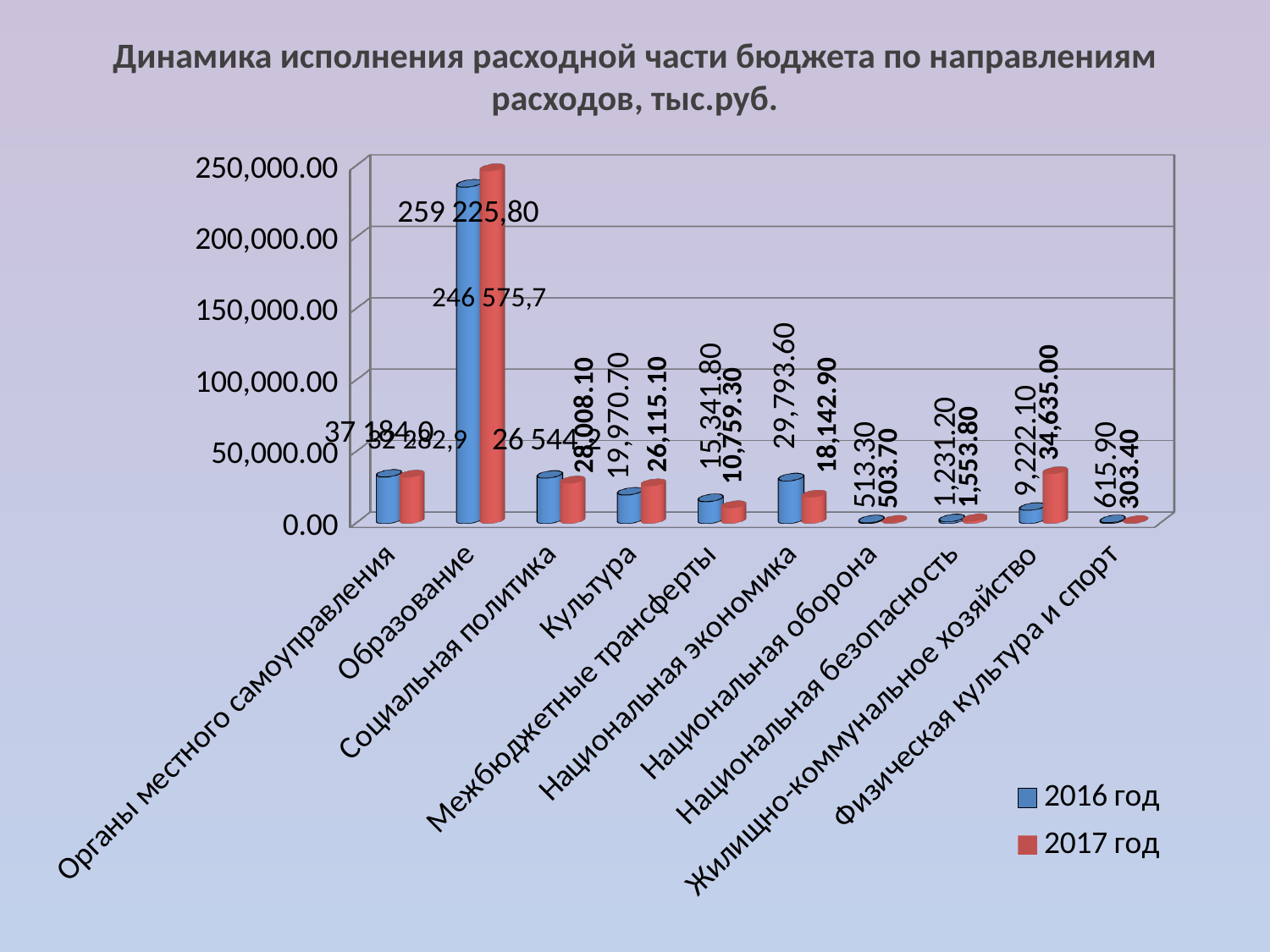
What is the difference between the 2017 год and 2016 год values for Культура? 6,144.40 What kind of chart is shown on the slide? Bar chart What is the value for Культура in 2017 год? 26,115.10 How many expenditure categories are shown on the x axis? 10 Which category has the highest values in the chart? Образование What is the value for Культура in 2016 год? 19,970.70 What are the two entries listed in the legend? 2016 год and 2017 год For Жилищно-коммунальное хозяйство, which year has the larger value, 2016 год or 2017 год? 2017 год What is the value for Жилищно-коммунальное хозяйство in 2017 год? 34,635.00 How many series does the legend list? 2 What is the value for Межбюджетные трансферты in 2017 год? 10,759.30 What is the value for Национальная экономика in 2016 год? 29,793.60